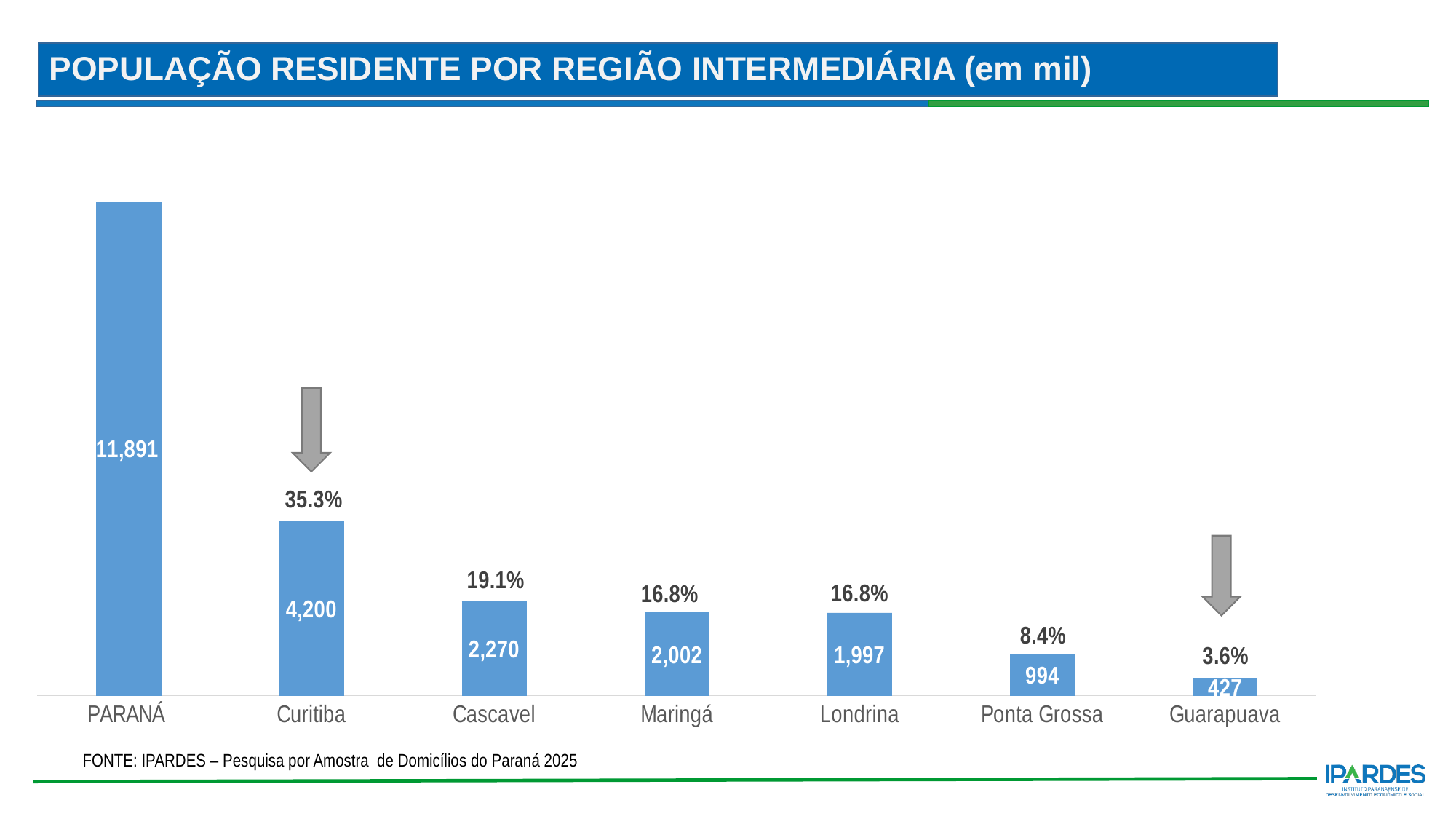
How many categories are shown on the x axis? 7 What percentage is shown above the Cascavel bar? 19.1% Which is larger, the value for Ponta Grossa or the value for Guarapuava? Ponta Grossa What is the title of the chart? POPULAÇÃO RESIDENTE POR REGIÃO INTERMEDIÁRIA (em mil) Which category has the highest value? PARANÁ What is the value for PARANÁ? 11,891 What is the value for Curitiba? 4,200 Do the values rise or fall from Curitiba to Guarapuava along the x axis? fall What is the value for Guarapuava? 427 What is the difference between the values for Curitiba and Cascavel? 1,930 Which category has the lowest value? Guarapuava What kind of chart is this? bar chart